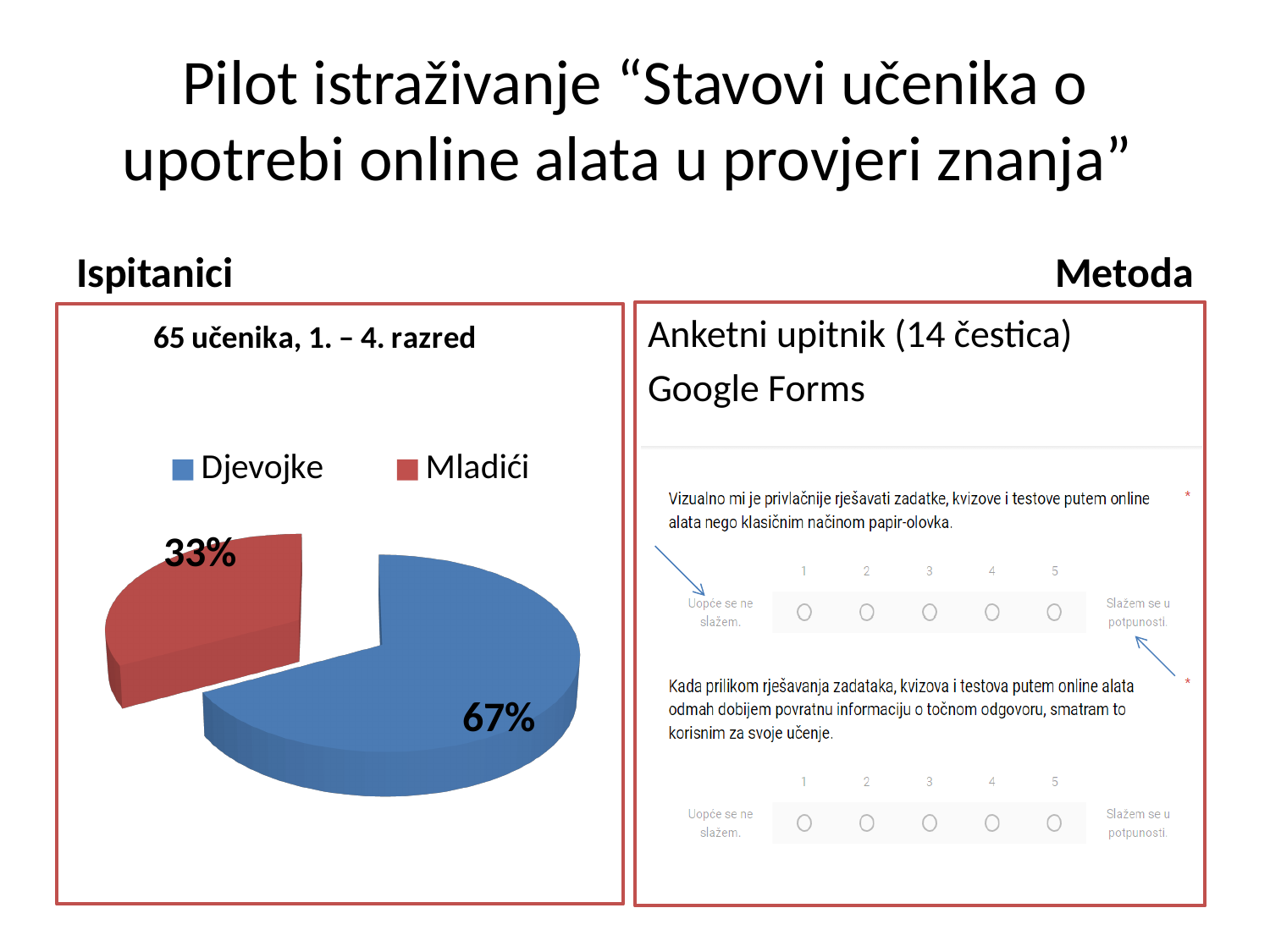
What is the share for Djevojke in the pie chart? 67% Which is larger, the share for Djevojke or the share for Mladići? Djevojke What is the share for Mladići in the pie chart? 33% What kind of chart is shown on the slide? pie chart Which category has the smallest slice in the pie chart? Mladići How many entries does the legend of the pie chart list? 2 Which category has the largest slice in the pie chart? Djevojke What is the title of the pie chart? 65 učenika, 1. – 4. razred What is the difference in percentage points between Djevojke and Mladići? 34 How many categories does the pie chart show? 2 What colour is the Mladići slice in the pie chart? red